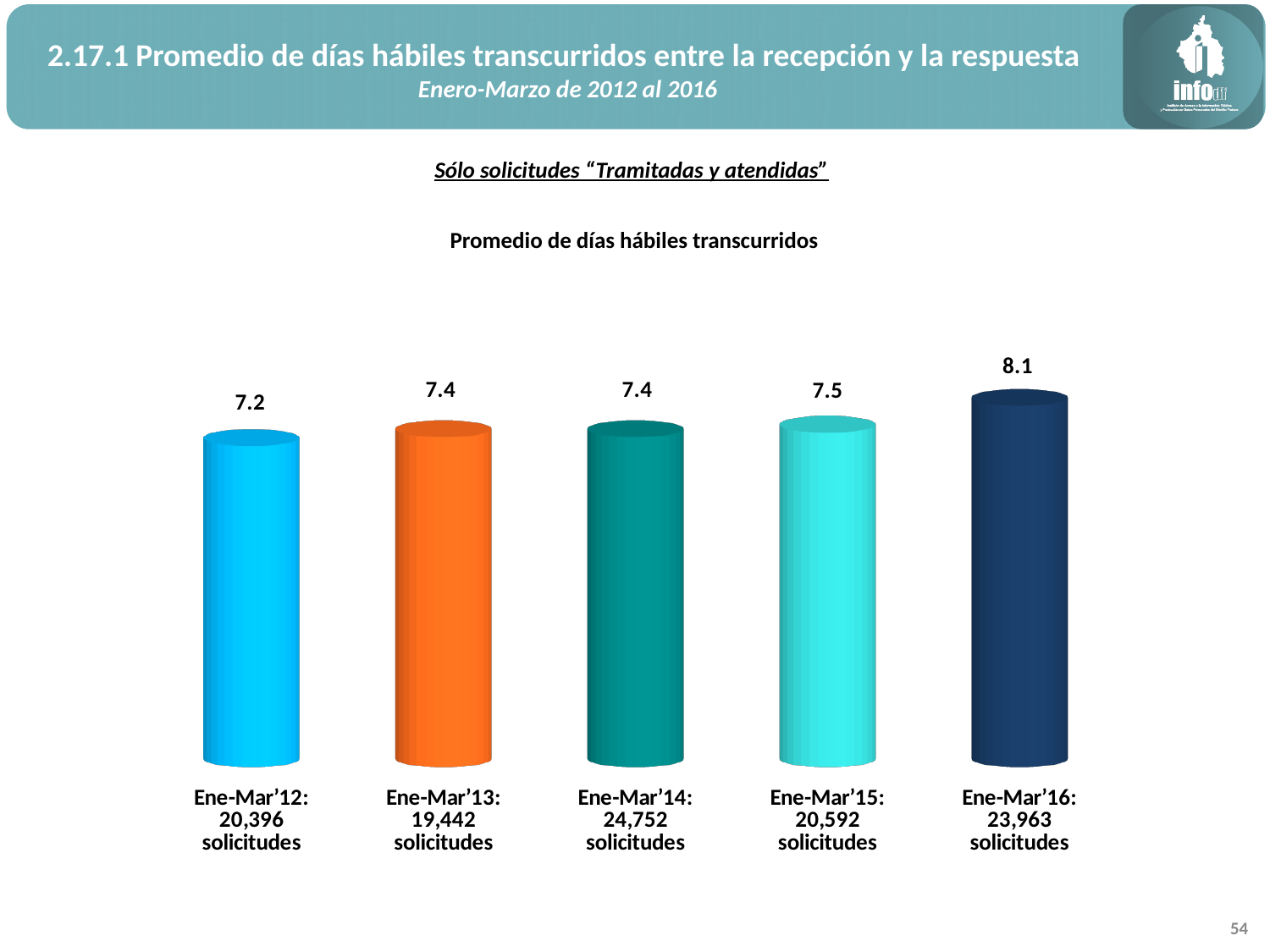
What is the average number of business days for Ene-Mar'12? 7.2 What is the difference between the values for Ene-Mar'16 and Ene-Mar'12? 0.9 What is the average number of business days for Ene-Mar'16? 8.1 Which period has the highest average number of business days? Ene-Mar'16 What kind of chart is shown on the slide? Bar chart How many solicitudes are listed under the Ene-Mar'14 label? 24,752 How many periods are shown in the chart? 5 Do the values generally rise or fall from Ene-Mar'12 to Ene-Mar'16? Rise Which period has the lowest average number of business days? Ene-Mar'12 What is the average number of business days for Ene-Mar'15? 7.5 What is the difference between the values for Ene-Mar'15 and Ene-Mar'14? 0.1 Which is larger, the value for Ene-Mar'16 or the value for Ene-Mar'15? Ene-Mar'16